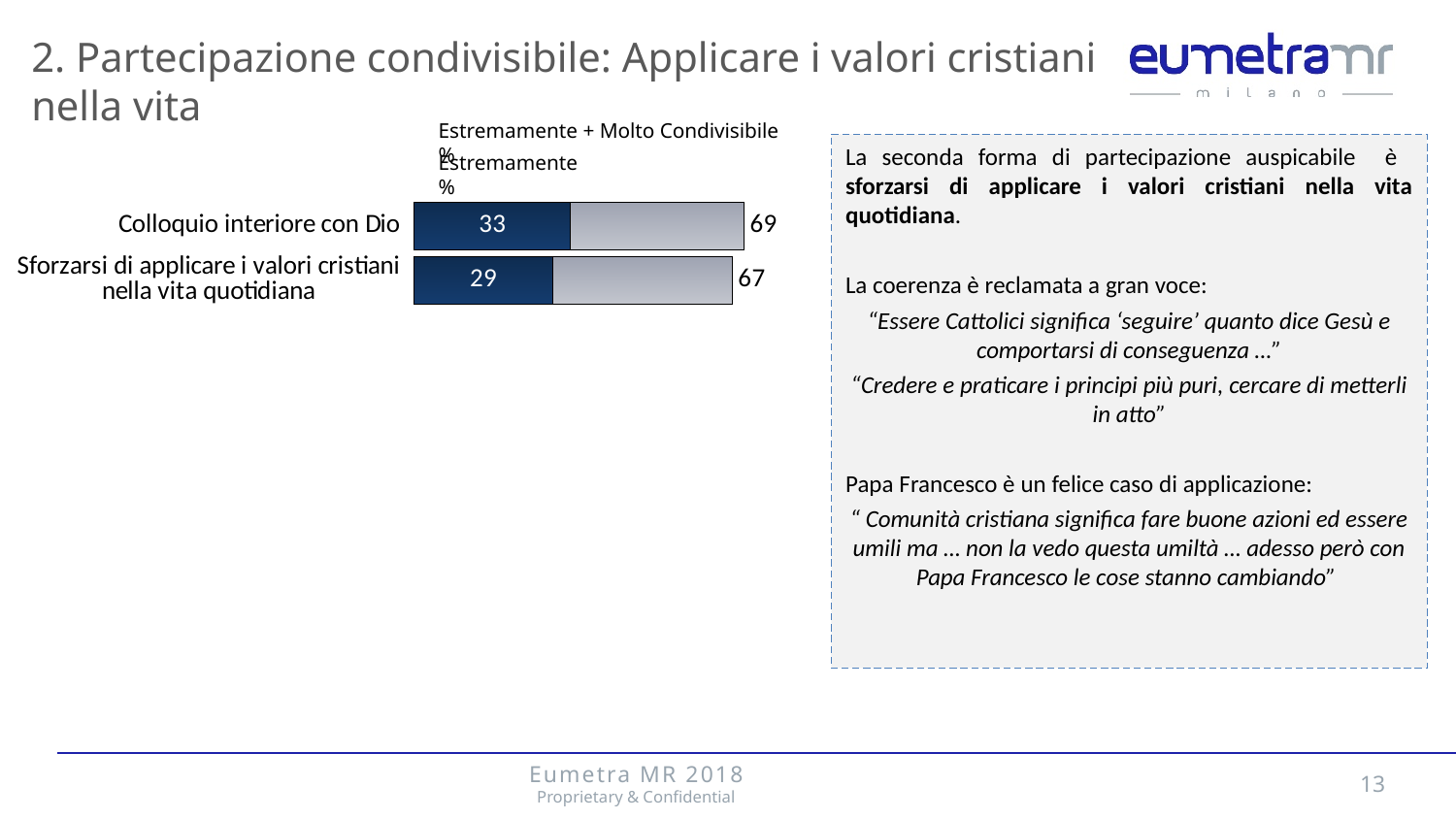
What does the dark blue segment of each bar represent? Estremamente % Which category has the lowest "Estremamente + Molto Condivisibile %" value? Sforzarsi di applicare i valori cristiani nella vita quotidiana What is the "Estremamente + Molto Condivisibile %" value for "Sforzarsi di applicare i valori cristiani nella vita quotidiana"? 67 What is the difference between the "Estremamente + Molto Condivisibile %" values of "Colloquio interiore con Dio" and "Sforzarsi di applicare i valori cristiani nella vita quotidiana"? 2 What is the "Estremamente + Molto Condivisibile %" value for "Colloquio interiore con Dio"? 69 What is the "Estremamente %" value for "Colloquio interiore con Dio"? 33 What is the difference between the "Estremamente %" values of "Colloquio interiore con Dio" and "Sforzarsi di applicare i valori cristiani nella vita quotidiana"? 4 What kind of chart is shown on the slide? Bar chart What is the "Estremamente %" value for "Sforzarsi di applicare i valori cristiani nella vita quotidiana"? 29 How many categories are shown in the chart? 2 Which category has the highest "Estremamente %" value? Colloquio interiore con Dio Which has a larger "Estremamente + Molto Condivisibile %" value: "Colloquio interiore con Dio" or "Sforzarsi di applicare i valori cristiani nella vita quotidiana"? Colloquio interiore con Dio